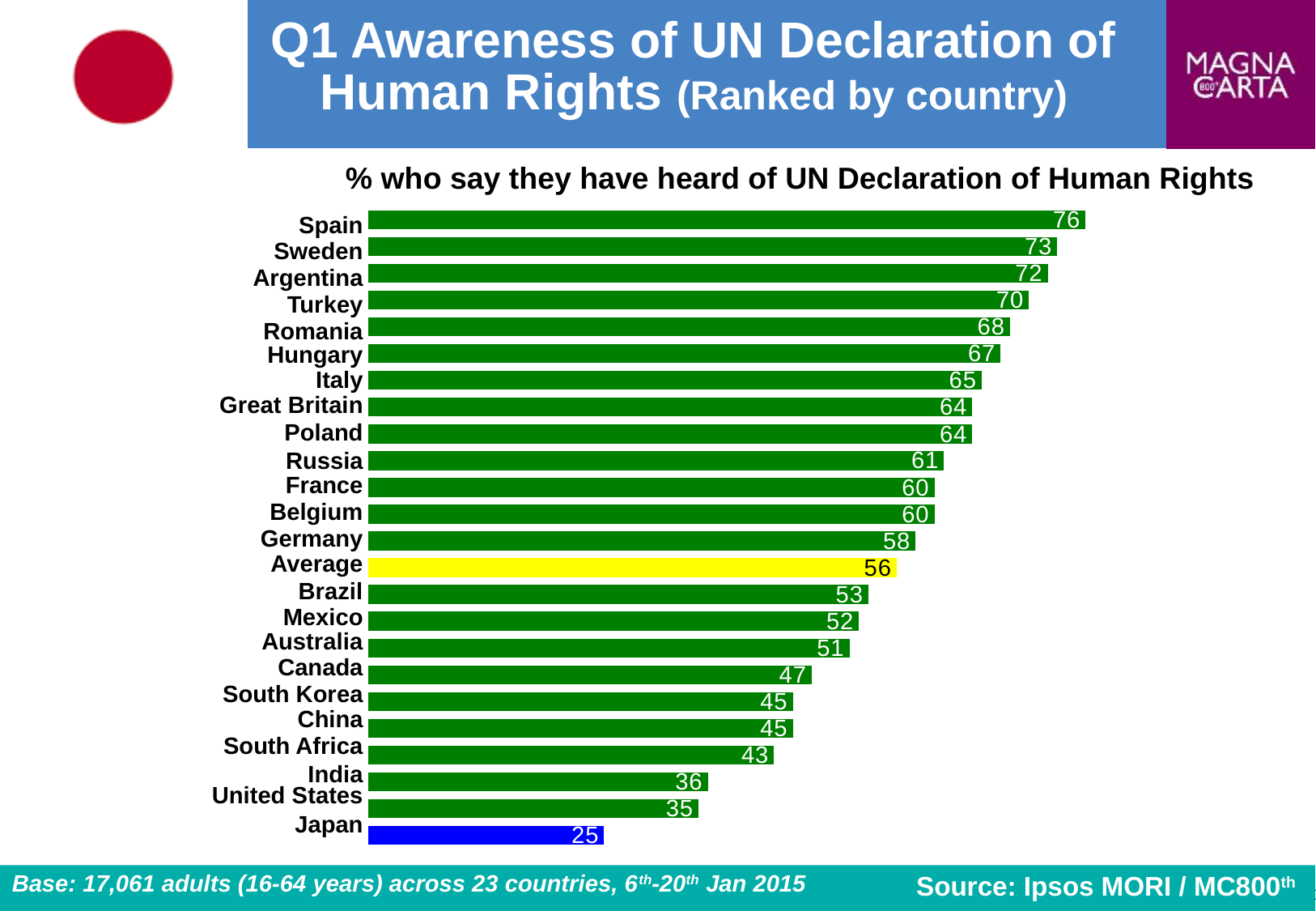
Which country has the highest value? Spain Which country has the lowest value? Japan What is the difference between the values for Spain and Japan? 51 How many bars are shown in the chart, including the Average bar? 24 Which bar is coloured blue? Japan Which has a larger value, India or South Africa? South Africa What is the value for Japan? 25 What kind of chart is shown on the slide? Bar chart Which has a larger value, Brazil or Australia? Brazil What is the value for Germany? 58 What is the difference between the values for Canada and the United States? 12 What is the value shown for the Average bar? 56